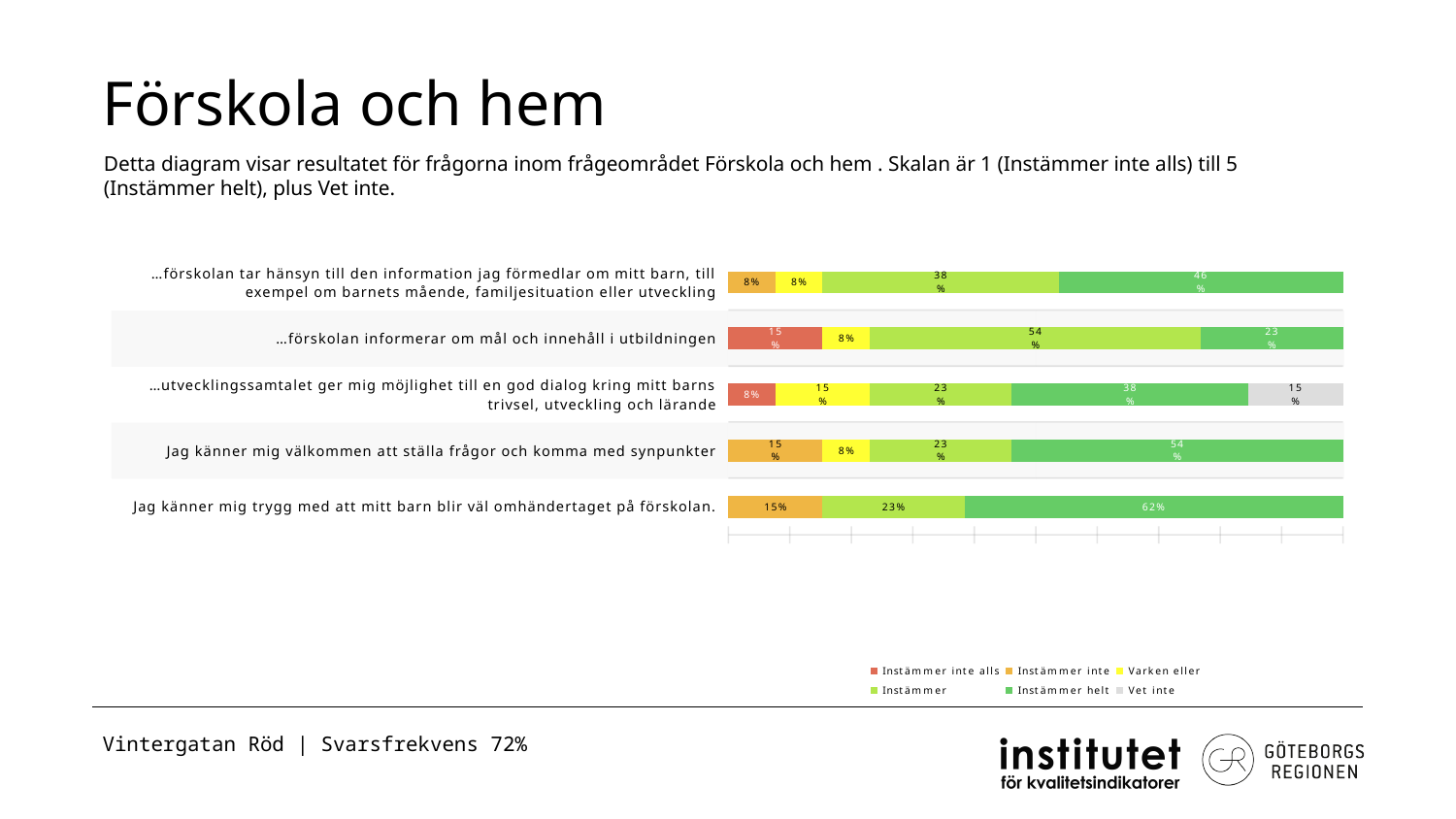
How many statements (bars) are shown in the chart? 5 What colour represents "Vet inte" in the legend? Grey Which statement has the highest share of "Instämmer helt"? Jag känner mig trygg med att mitt barn blir väl omhändertaget på förskolan. What percentage answered "Instämmer inte alls" for "…förskolan informerar om mål och innehåll i utbildningen"? 15% Which statement has the lowest share of "Instämmer helt"? …förskolan informerar om mål och innehåll i utbildningen How many response categories does the legend list? 6 What percentage answered "Instämmer" for "…förskolan informerar om mål och innehåll i utbildningen"? 54% Which has a larger "Instämmer helt" share: "…förskolan tar hänsyn till den information jag förmedlar om mitt barn…" or "…förskolan informerar om mål och innehåll i utbildningen"? …förskolan tar hänsyn till den information jag förmedlar om mitt barn… What percentage answered "Instämmer helt" for "Jag känner mig trygg med att mitt barn blir väl omhändertaget på förskolan."? 62% What kind of chart is shown on the slide? Stacked bar chart What percentage answered "Vet inte" for "…utvecklingssamtalet ger mig möjlighet till en god dialog kring mitt barns trivsel, utveckling och lärande"? 15% What is the difference in "Instämmer helt" between "Jag känner mig trygg med att mitt barn blir väl omhändertaget på förskolan." (62%) and "Jag känner mig välkommen att ställa frågor och komma med synpunkter" (54%)? 8 percentage points